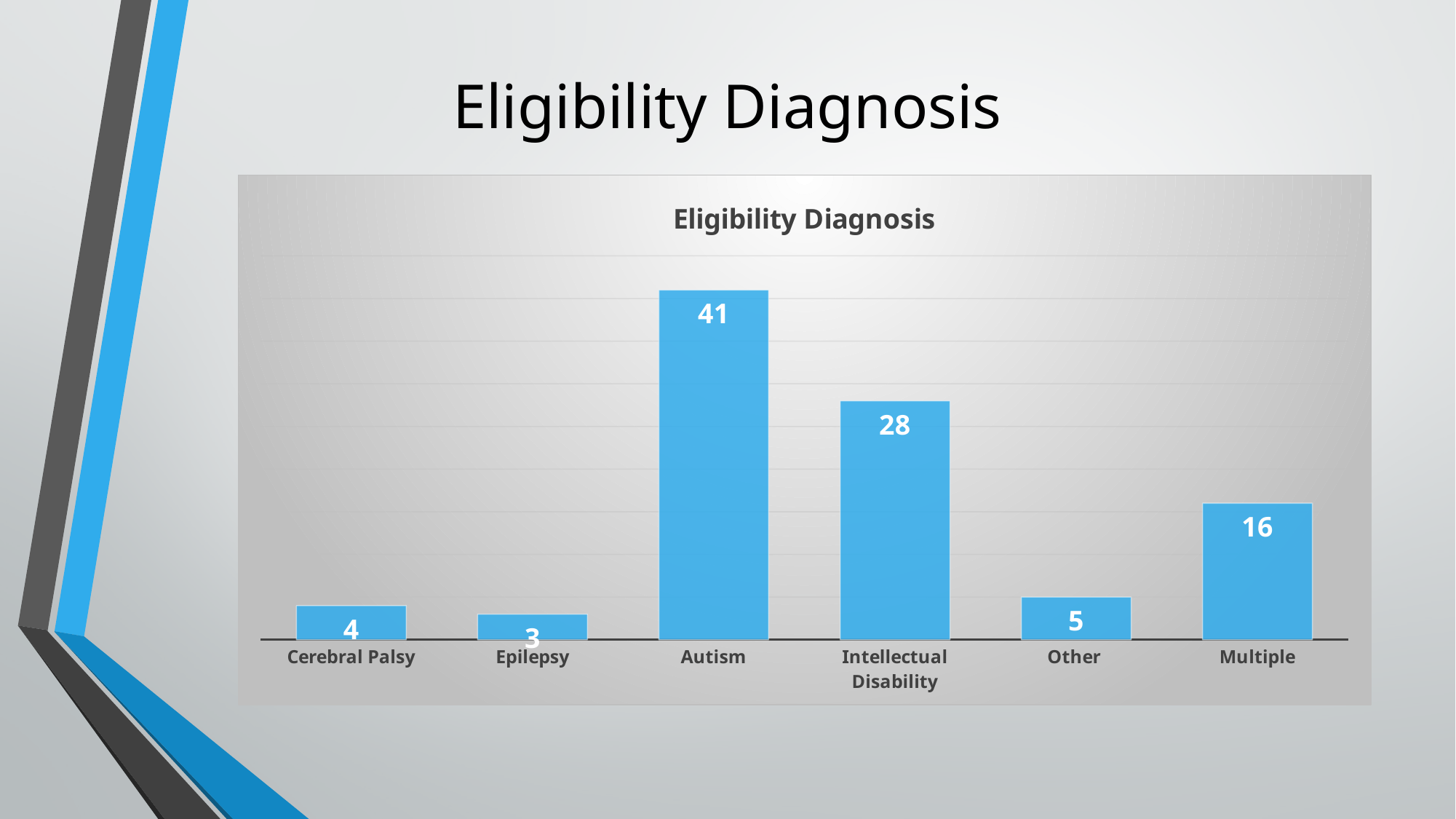
What is the difference between the values for Multiple and Other? 11 What is the value for Autism? 41 How many categories are shown on the x axis? 6 Which is larger, the value for Cerebral Palsy or the value for Other? Other What is the value for Multiple? 16 What is the value for Intellectual Disability? 28 What kind of chart is shown on the slide? Bar chart What is the difference between the values for Autism and Intellectual Disability? 13 What is the title of the chart? Eligibility Diagnosis What is the value for Epilepsy? 3 Which category has the highest value? Autism Which category has the lowest value? Epilepsy